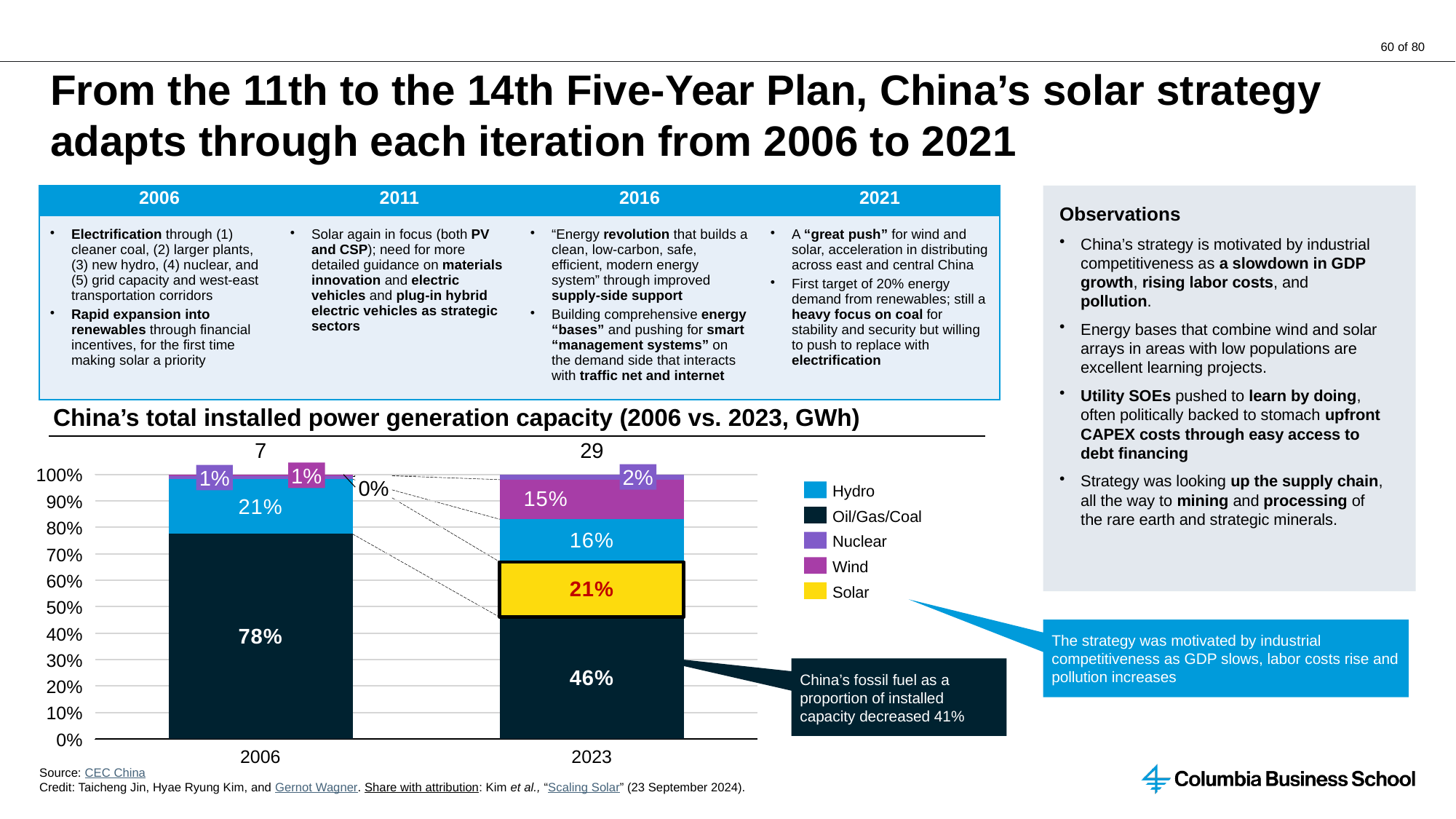
What total value is printed above the 2023 bar? 29 Which source has the largest share of installed capacity in 2023? Oil/Gas/Coal What is the Hydro share of China's installed capacity in 2006? 21% How many series does the legend list? 5 What kind of chart is shown on the slide? Stacked bar chart What is the Wind share of China's installed capacity in 2023? 15% What is the Solar share of China's installed capacity in 2023? 21% What is the Oil/Gas/Coal share of China's installed capacity in 2023? 46% What is the Nuclear share of China's installed capacity in 2023? 2% What is the Oil/Gas/Coal share of China's installed capacity in 2006? 78% Which is larger in 2023, the Hydro share or the Wind share? Hydro By how many percentage points did the Oil/Gas/Coal share fall from 2006 to 2023? 32 percentage points